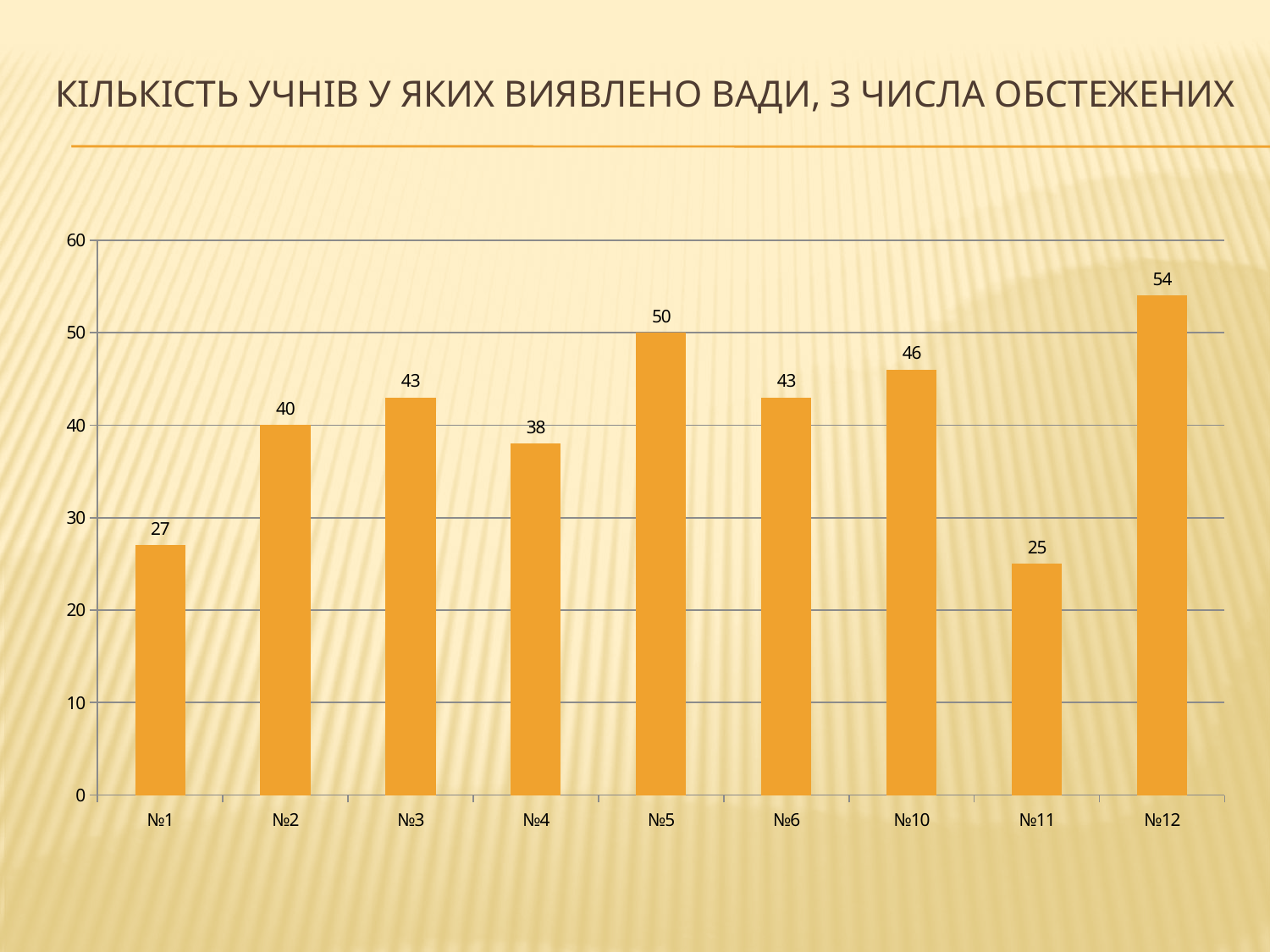
What kind of chart is shown on the slide? bar chart What is the difference between the values for №12 and №1? 27 What is the value for №10? 46 Is the value for №6 greater or less than 40? greater Which category has the lowest value? №11 What is the value for №11? 25 What is the difference between the values for №3 and №6? 0 What is the value for №5? 50 Which is larger, the value for №2 or the value for №4? №2 What is the title of the slide? КІЛЬКІСТЬ УЧНІВ У ЯКИХ ВИЯВЛЕНО ВАДИ, З ЧИСЛА ОБСТЕЖЕНИХ Which category has the highest value? №12 How many categories are shown on the x axis? 9